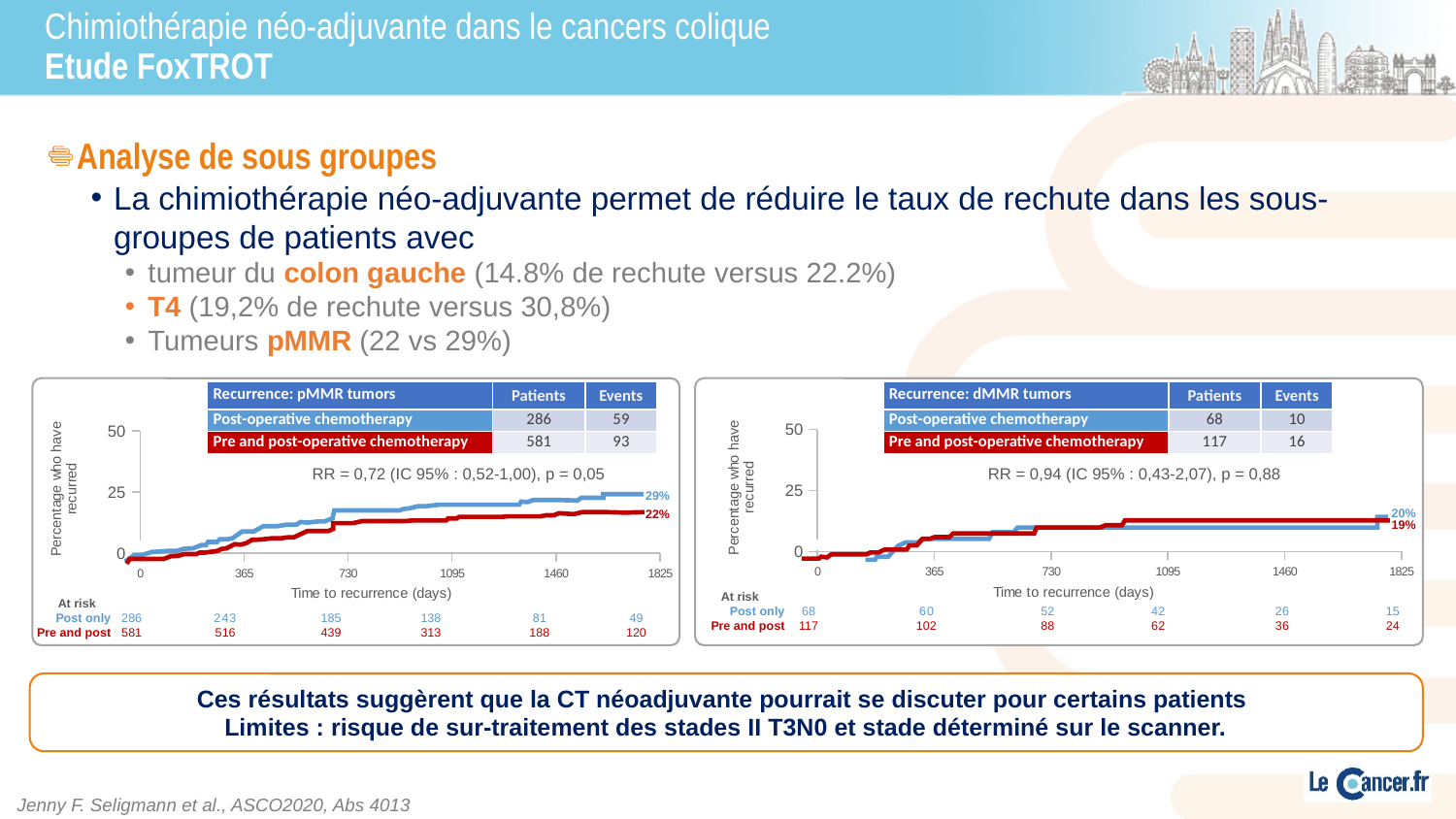
In the 'Recurrence: pMMR tumors' chart, what is the final recurrence percentage labelled for the pre and post-operative chemotherapy curve? 22% In the 'Recurrence: pMMR tumors' chart, what is the final recurrence percentage labelled for the post-operative chemotherapy curve? 29% In the 'Recurrence: dMMR tumors' chart, what is the final recurrence percentage labelled for the pre and post-operative chemotherapy curve? 20% In the 'Recurrence: pMMR tumors' chart, what is the difference between the final recurrence percentages of the two curves? 7% In the 'Recurrence: dMMR tumors' chart, how many events are listed for the post-operative chemotherapy group? 10 In the 'Recurrence: pMMR tumors' chart, how many patients are listed for the pre and post-operative chemotherapy group? 581 In the 'Recurrence: pMMR tumors' chart, which curve ends with the higher recurrence percentage? Post-operative chemotherapy In the 'Recurrence: dMMR tumors' chart, is the final value of the post-operative chemotherapy curve greater or less than 25? less What kind of chart is the 'Recurrence: pMMR tumors' chart? Line chart In the 'Recurrence: dMMR tumors' chart, what is the final recurrence percentage labelled for the post-operative chemotherapy curve? 19% In the 'Recurrence: pMMR tumors' chart, how many 'Post only' patients are at risk at 1095 days? 138 How many series does the legend of the 'Recurrence: dMMR tumors' chart list? 2